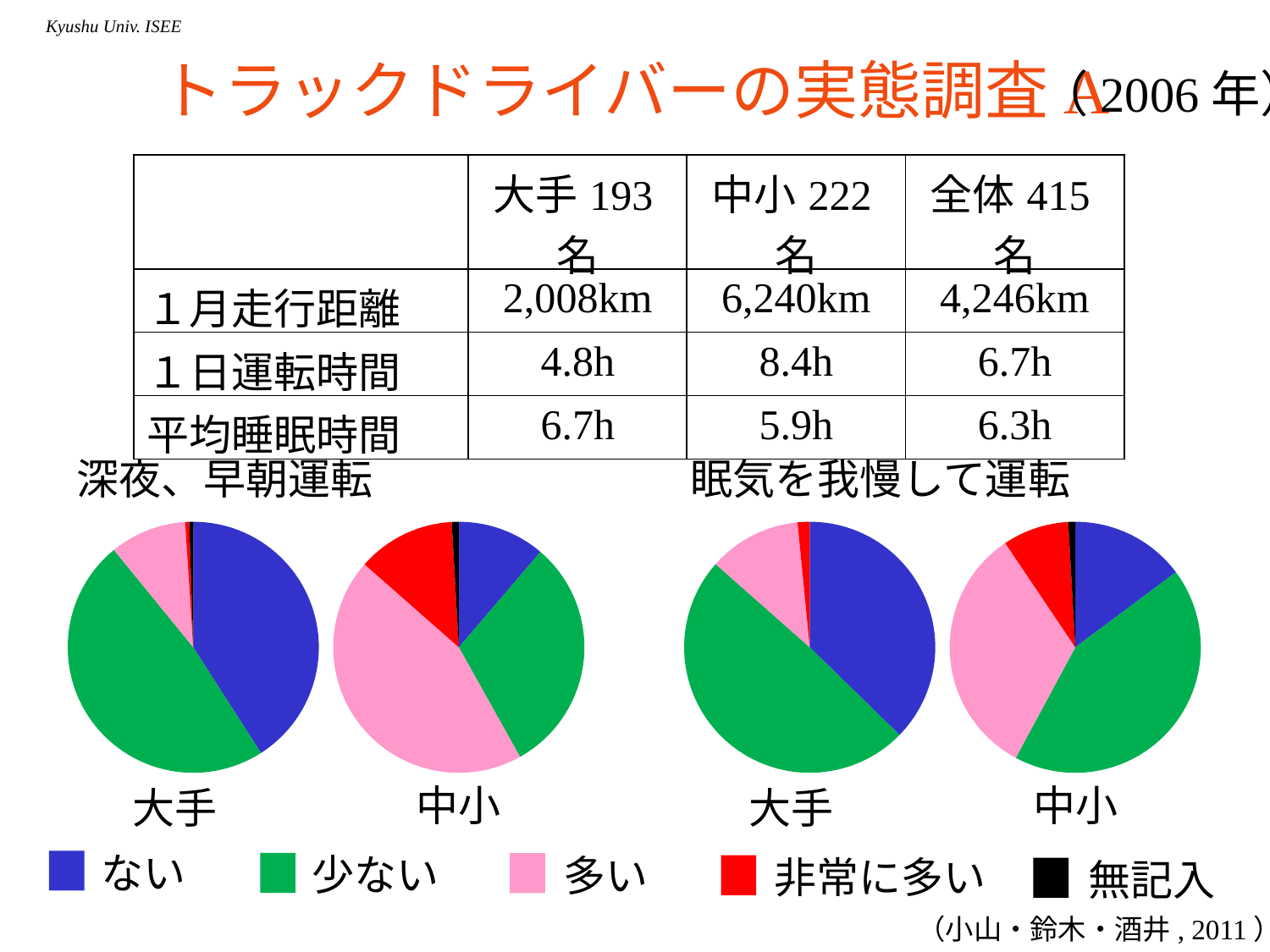
Which colour represents ない in the pie chart legend? Blue In the 深夜、早朝運転 中小 pie chart, which category has the smallest slice? 無記入 What kind of charts are shown on the slide? Pie charts In the 深夜、早朝運転 中小 pie chart, which category has the largest slice? 多い In the 眠気を我慢して運転 中小 pie chart, which category has the largest slice? 少ない In the 眠気を我慢して運転 中小 pie chart, which category has the smallest slice? 無記入 In the 眠気を我慢して運転 大手 pie chart, which slice is larger: 多い or 非常に多い? 多い For 深夜、早朝運転, which pie chart has the larger 非常に多い slice: 大手 or 中小? 中小 How many pie charts are on the slide? 4 Which colour represents 多い in the pie chart legend? Pink In the 深夜、早朝運転 大手 pie chart, which slice is larger: 多い or 非常に多い? 多い How many categories does the legend list for the pie charts? 5